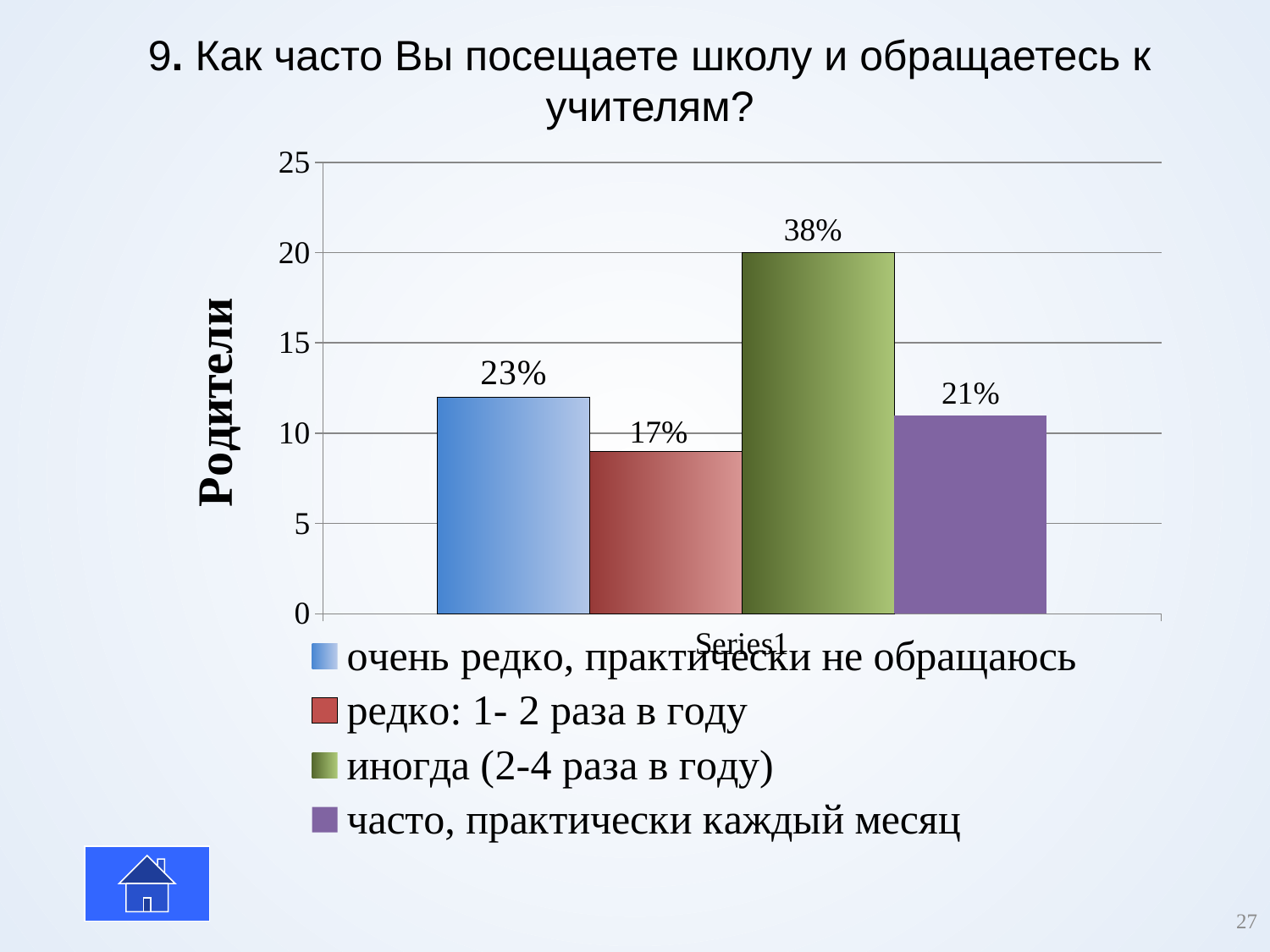
Which bar is taller: "очень редко, практически не обращаюсь" or "часто, практически каждый месяц"? очень редко, практически не обращаюсь What is the data label shown on the bar for "часто, практически каждый месяц"? 21% What is the data label shown on the bar for "очень редко, практически не обращаюсь"? 23% Which legend entry has the lowest bar? редко: 1- 2 раза в году What is the data label shown on the bar for "иногда (2-4 раза в году)"? 38% What is the data label shown on the bar for "редко: 1- 2 раза в году"? 17% What is the title of the vertical axis? Родители What is the difference in percentage points between the labels for "иногда (2-4 раза в году)" and "редко: 1- 2 раза в году"? 21 How many entries does the legend list? 4 What kind of chart is shown on the slide? bar chart Which legend entry has the highest bar? иногда (2-4 раза в году) Is the bar for "иногда (2-4 раза в году)" greater or less than 15 on the vertical axis? greater